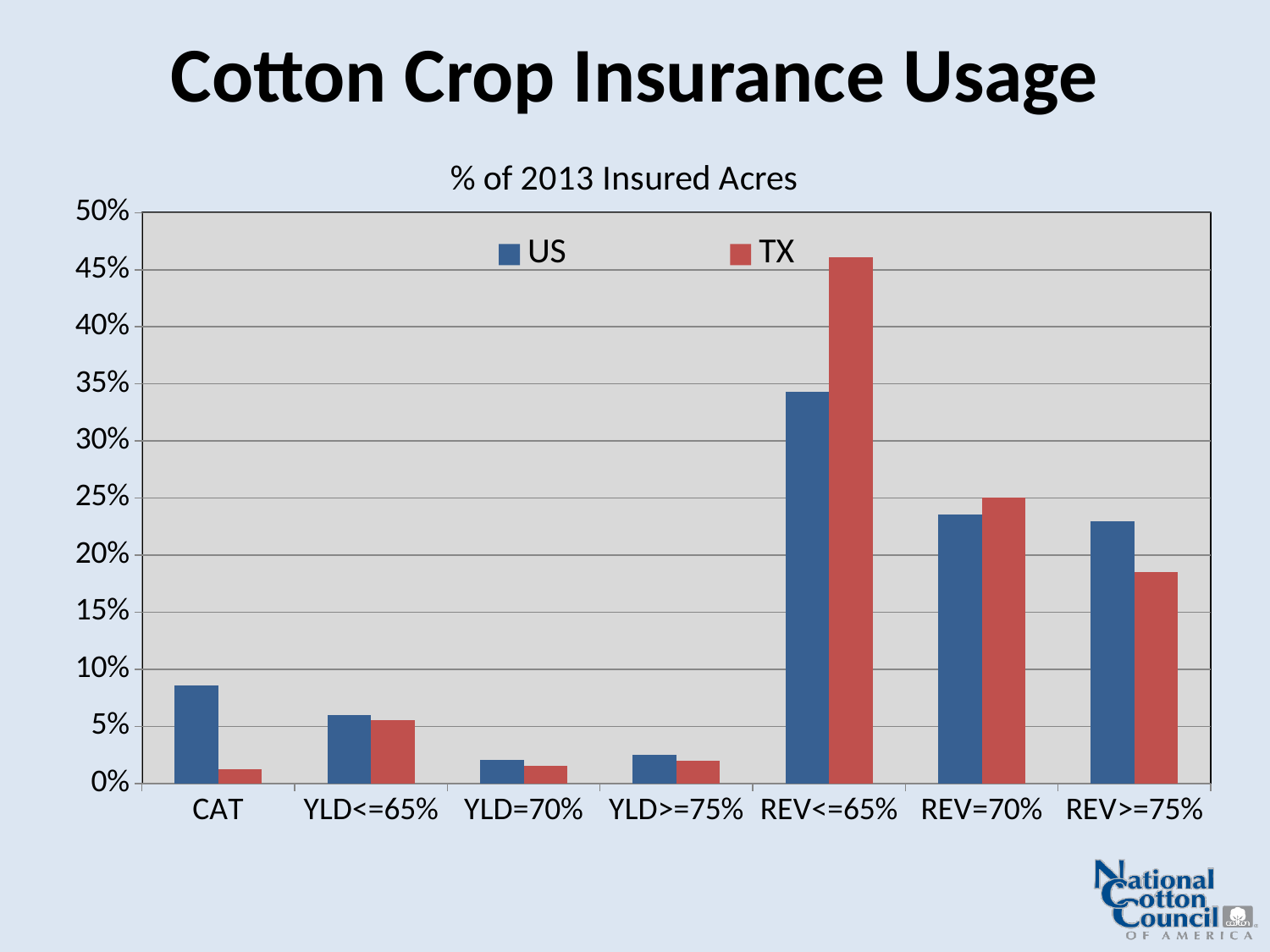
Is the TX value for REV<=65% greater or less than 40%? greater Is the US value for CAT greater or less than 10%? less For REV<=65%, which series has the larger value, US or TX? TX Which category has the highest value for the US series? REV<=65% For REV>=75%, which series has the larger value, US or TX? US For CAT, which series has the larger value, US or TX? US How many series does the legend list? 2 What kind of chart is shown on the slide? Bar chart Is the TX value for REV>=75% greater or less than 20%? less What is the subtitle shown above the chart? % of 2013 Insured Acres How many categories are shown on the x axis? 7 Which category has the highest value for the TX series? REV<=65%